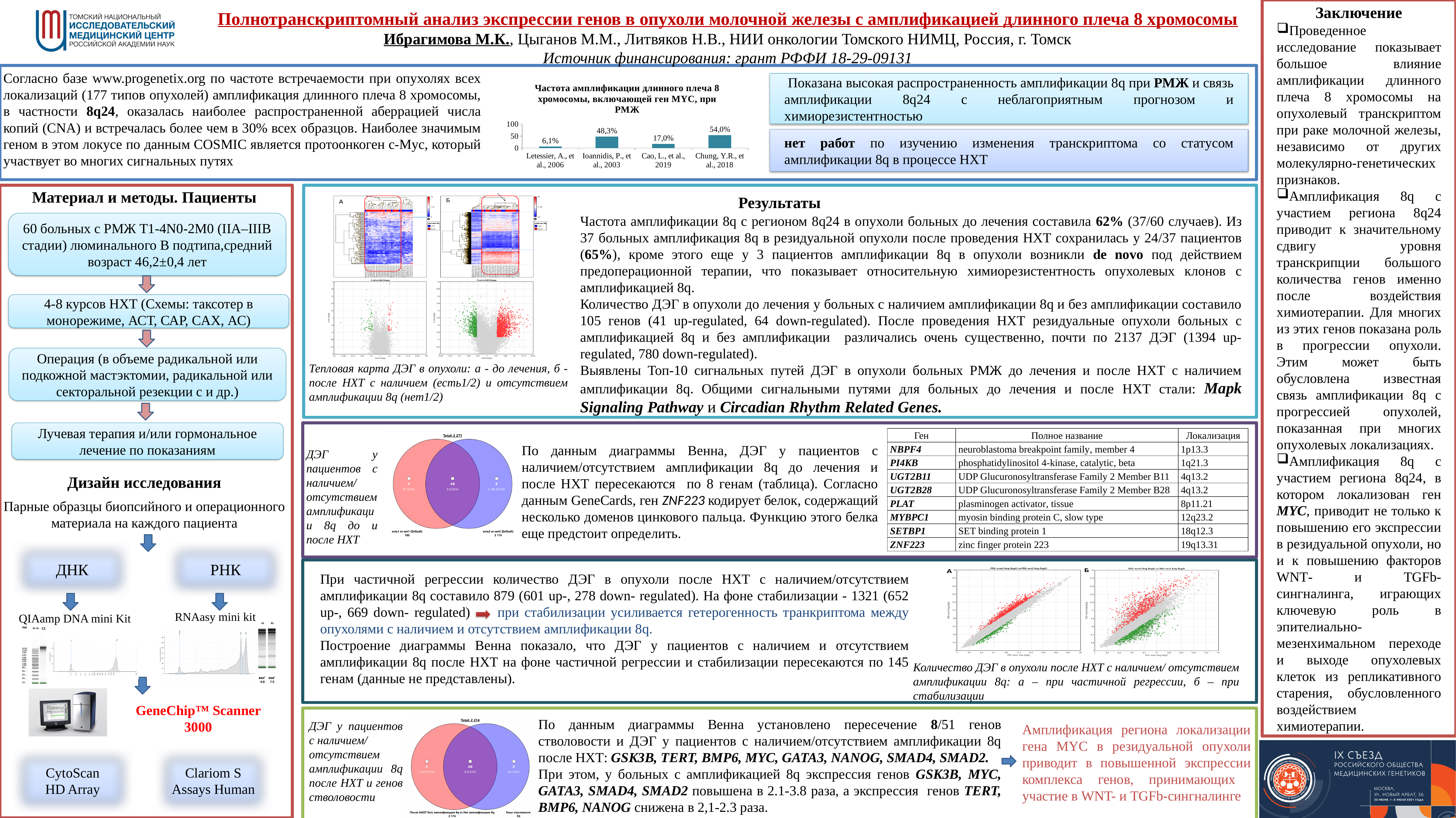
In the bar chart 'Частота амплификации длинного плеча 8 хромосомы, включающей ген MYC, при РМЖ', is the value for Ioannidis, P., et al., 2003 greater or less than 50? less In the bar chart 'Частота амплификации длинного плеча 8 хромосомы, включающей ген MYC, при РМЖ', which is larger: the value for Cao, L., et al., 2019 or for Letessier, A., et al., 2006? Cao, L., et al., 2019 What is the maximum value shown on the vertical axis of the bar chart 'Частота амплификации длинного плеча 8 хромосомы, включающей ген MYC, при РМЖ'? 100 In the bar chart 'Частота амплификации длинного плеча 8 хромосомы, включающей ген MYC, при РМЖ', which study has the highest value? Chung, Y.R., et al., 2018 How many studies (bars) are shown in the bar chart 'Частота амплификации длинного плеча 8 хромосомы, включающей ген MYC, при РМЖ'? 4 In the bar chart 'Частота амплификации длинного плеча 8 хромосомы, включающей ген MYC, при РМЖ', what is the value for Letessier, A., et al., 2006? 6,1% In the bar chart 'Частота амплификации длинного плеча 8 хромосомы, включающей ген MYC, при РМЖ', what is the difference between the values for Chung, Y.R., et al., 2018 and Ioannidis, P., et al., 2003? 5,7% In the bar chart 'Частота амплификации длинного плеча 8 хромосомы, включающей ген MYC, при РМЖ', what is the value for Cao, L., et al., 2019? 17,0% In the bar chart 'Частота амплификации длинного плеча 8 хромосомы, включающей ген MYC, при РМЖ', what is the value for Chung, Y.R., et al., 2018? 54,0% What kind of chart is 'Частота амплификации длинного плеча 8 хромосомы, включающей ген MYC, при РМЖ'? bar chart In the bar chart 'Частота амплификации длинного плеча 8 хромосомы, включающей ген MYC, при РМЖ', which study has the lowest value? Letessier, A., et al., 2006 In the bar chart 'Частота амплификации длинного плеча 8 хромосомы, включающей ген MYC, при РМЖ', what is the value for Ioannidis, P., et al., 2003? 48,3%